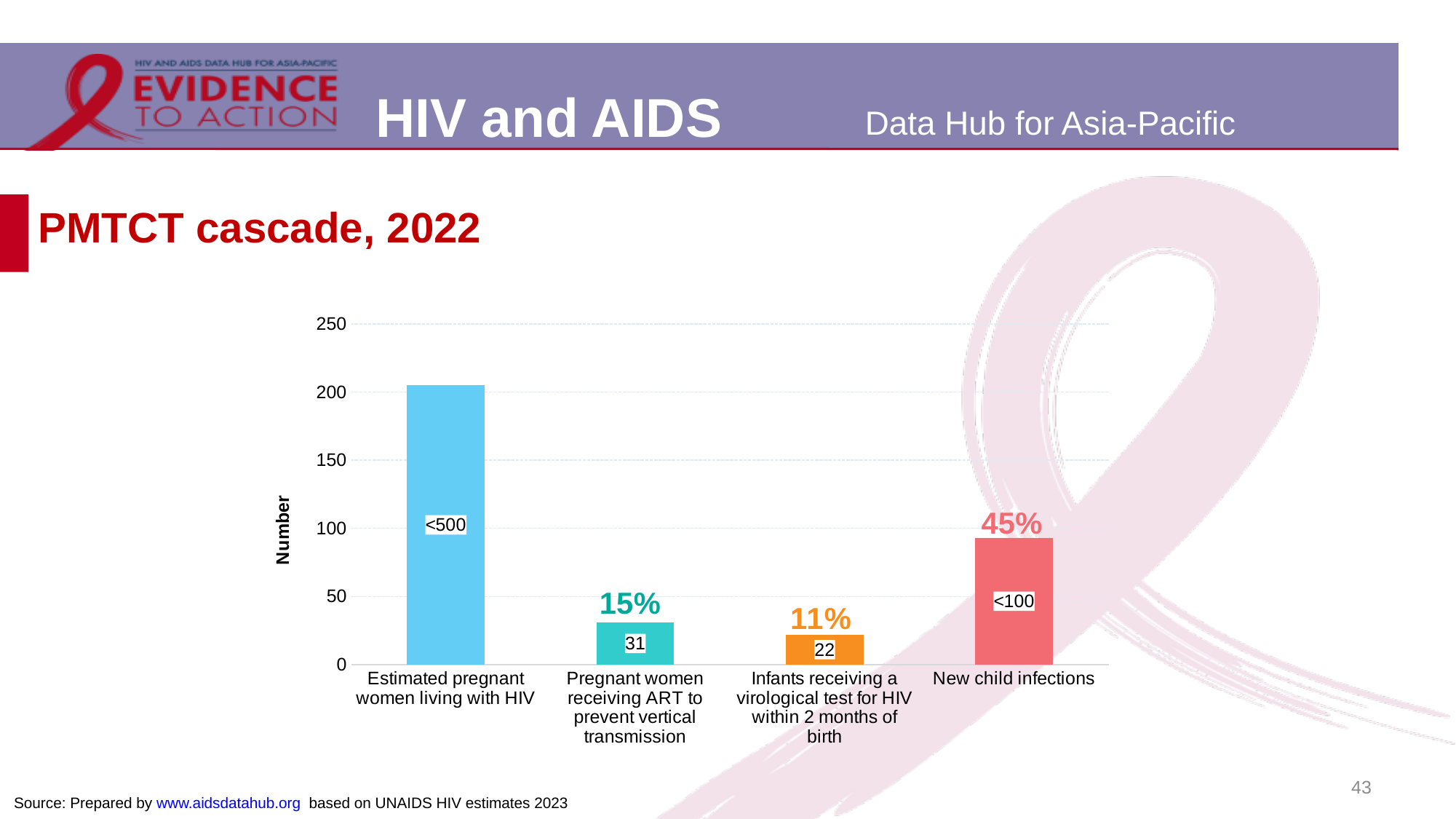
How many categories are shown on the x axis? 4 What data label is printed on the bar for estimated pregnant women living with HIV? <500 What percentage is shown above the bar for new child infections? 45% Which category has the shortest bar? Infants receiving a virological test for HIV within 2 months of birth What is the difference between the number of pregnant women receiving ART (31) and the number of infants receiving a virological test (22)? 9 What percentage is shown above the bar for pregnant women receiving ART to prevent vertical transmission? 15% What is the title of the chart? PMTCT cascade, 2022 Is the bar for estimated pregnant women living with HIV greater or less than 200? greater Which category has the tallest bar? Estimated pregnant women living with HIV What is the data label shown on the bar for pregnant women receiving ART to prevent vertical transmission? 31 What is the data label shown on the bar for infants receiving a virological test for HIV within 2 months of birth? 22 What data label is printed on the bar for new child infections? <100